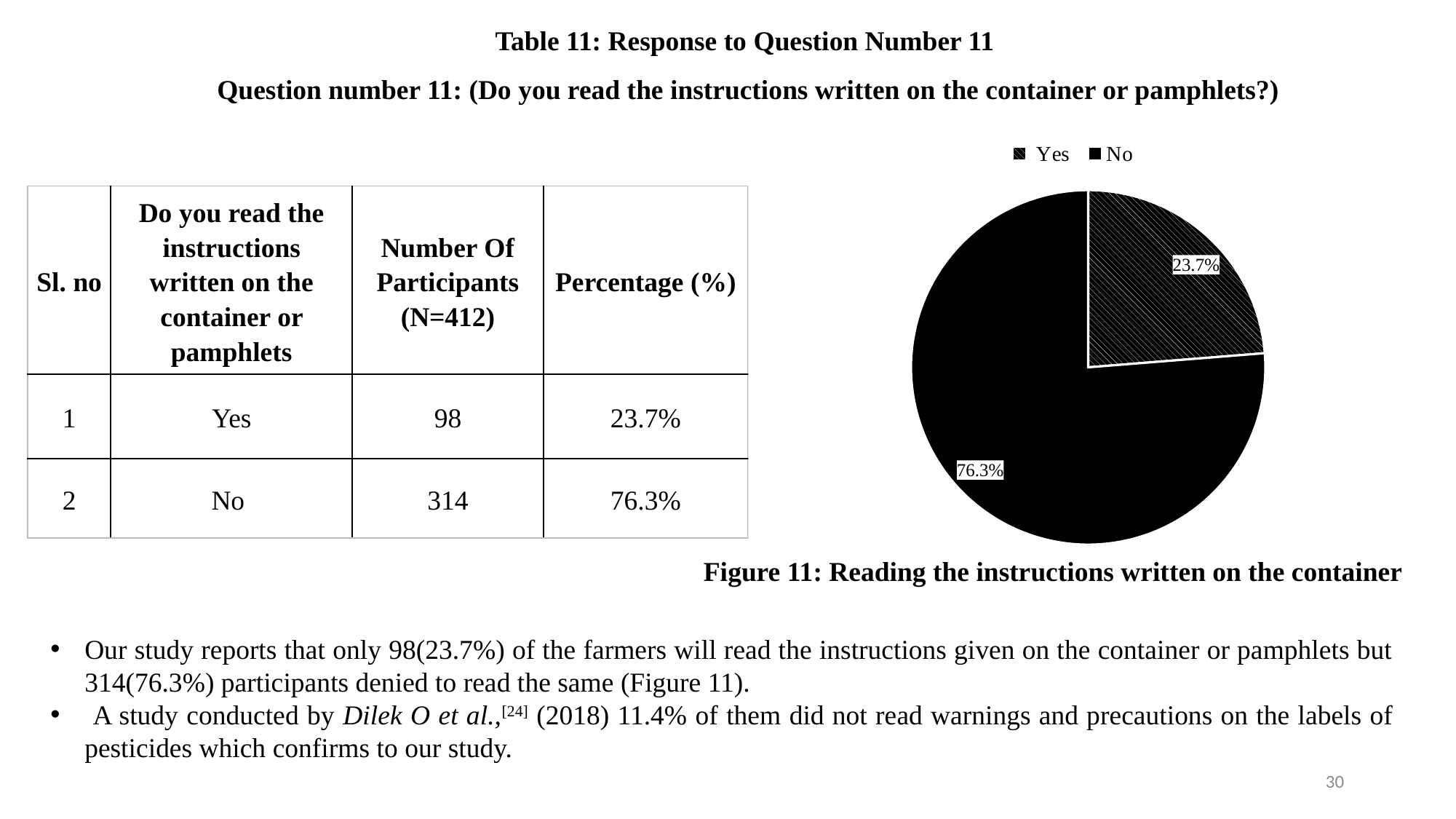
What share of the pie does the 'Yes' slice represent? 23.7% Which legend entry is shown with a hatched pattern in the pie chart? Yes Which slice of the pie chart is the largest? No How many slices does the pie chart have? 2 What share of the pie does the 'No' slice represent? 76.3% What is the caption of the pie chart? Figure 11: Reading the instructions written on the container Which is larger in the pie chart, the 'Yes' slice or the 'No' slice? No What kind of chart is shown in Figure 11? pie chart What is the difference in percentage points between the 'No' slice and the 'Yes' slice? 52.6 How many entries does the legend of the pie chart list? 2 Which slice of the pie chart is the smallest? Yes